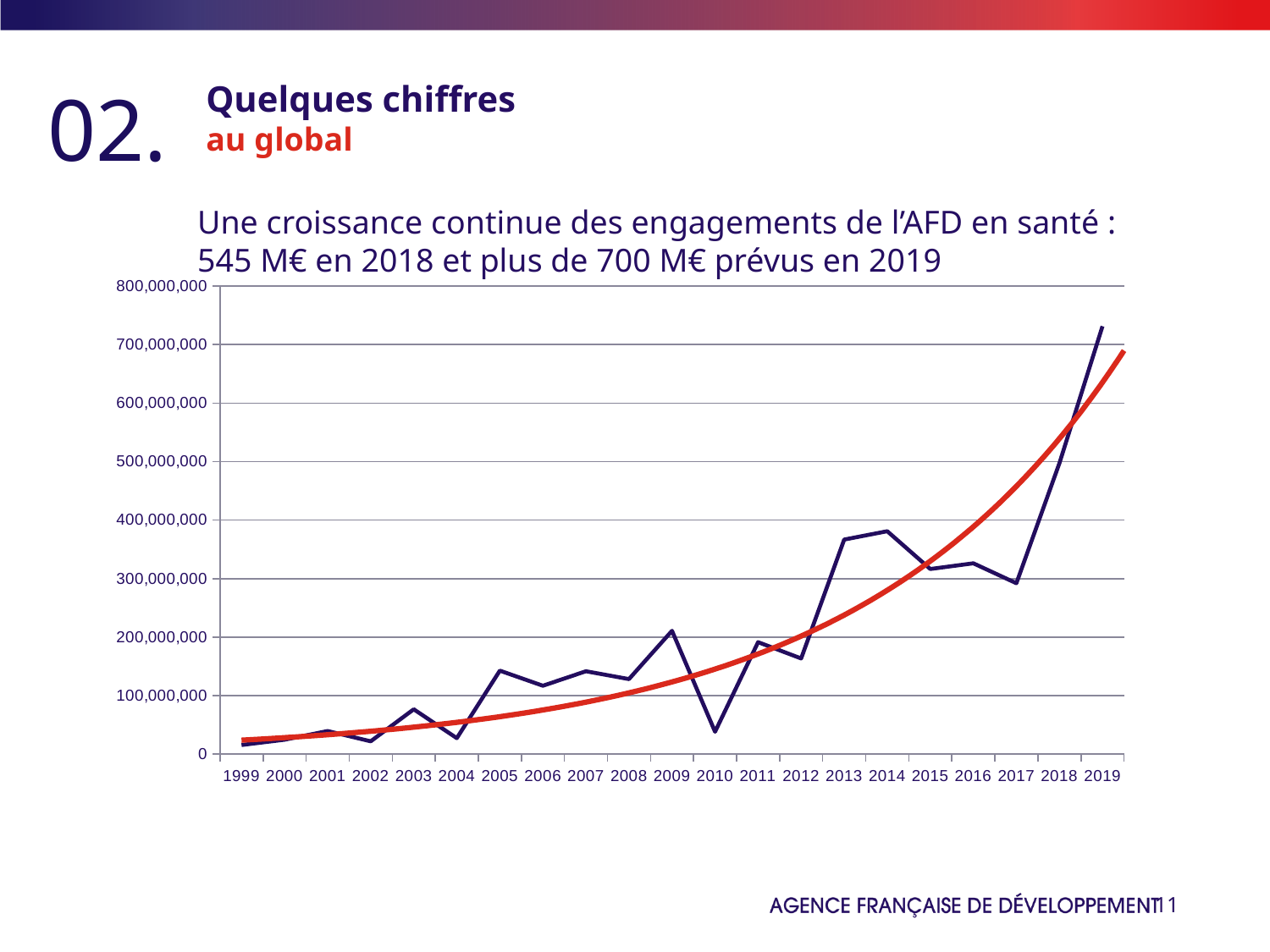
What colour is the smooth trend line drawn on the chart? red Is the value for 2012 on the dark blue line greater or less than 200,000,000? less Which year has the larger value on the dark blue line, 2013 or 2017? 2013 Is the value for 2014 on the dark blue line greater or less than 300,000,000? greater Is the value for 2010 on the dark blue line greater or less than 100,000,000? less Do the values on the dark blue line generally rise or fall from 1999 to 2019? rise Which year has the highest value on the dark blue line? 2019 Which year has the larger value on the dark blue line, 2009 or 2010? 2009 How many years are shown on the x axis of the chart? 21 What kind of chart is shown on the slide? line chart